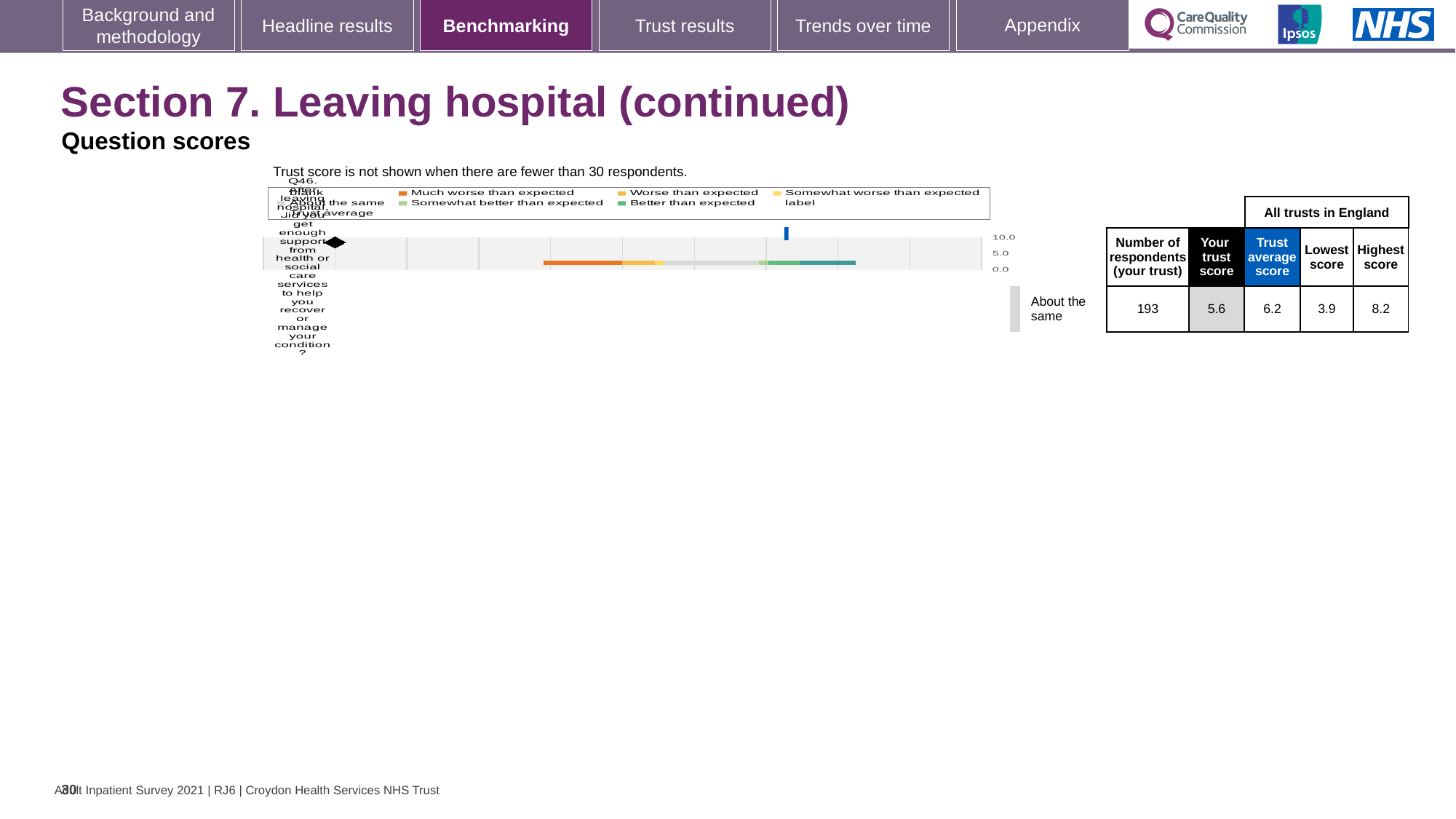
What is the trust average score across all trusts in England for Q46? 6.2 What benchmarking category is this trust's Q46 score assigned to? About the same Which is larger for Q46: this trust's score or the trust average score? Trust average score What is the difference between the trust average score and this trust's score for Q46? 0.6 How many questions are plotted on the chart? 1 What is the trust score for Q46 (support from health or social care services after leaving hospital)? 5.6 Is this trust's score for Q46 greater or less than 5.0? greater What is the highest score among all trusts in England for Q46? 8.2 What is the difference between the highest and lowest scores for Q46 across all trusts in England? 4.3 What kind of chart is used to show the Q46 benchmarking result? Bar chart What is the lowest score among all trusts in England for Q46? 3.9 How many respondents from the trust answered Q46? 193